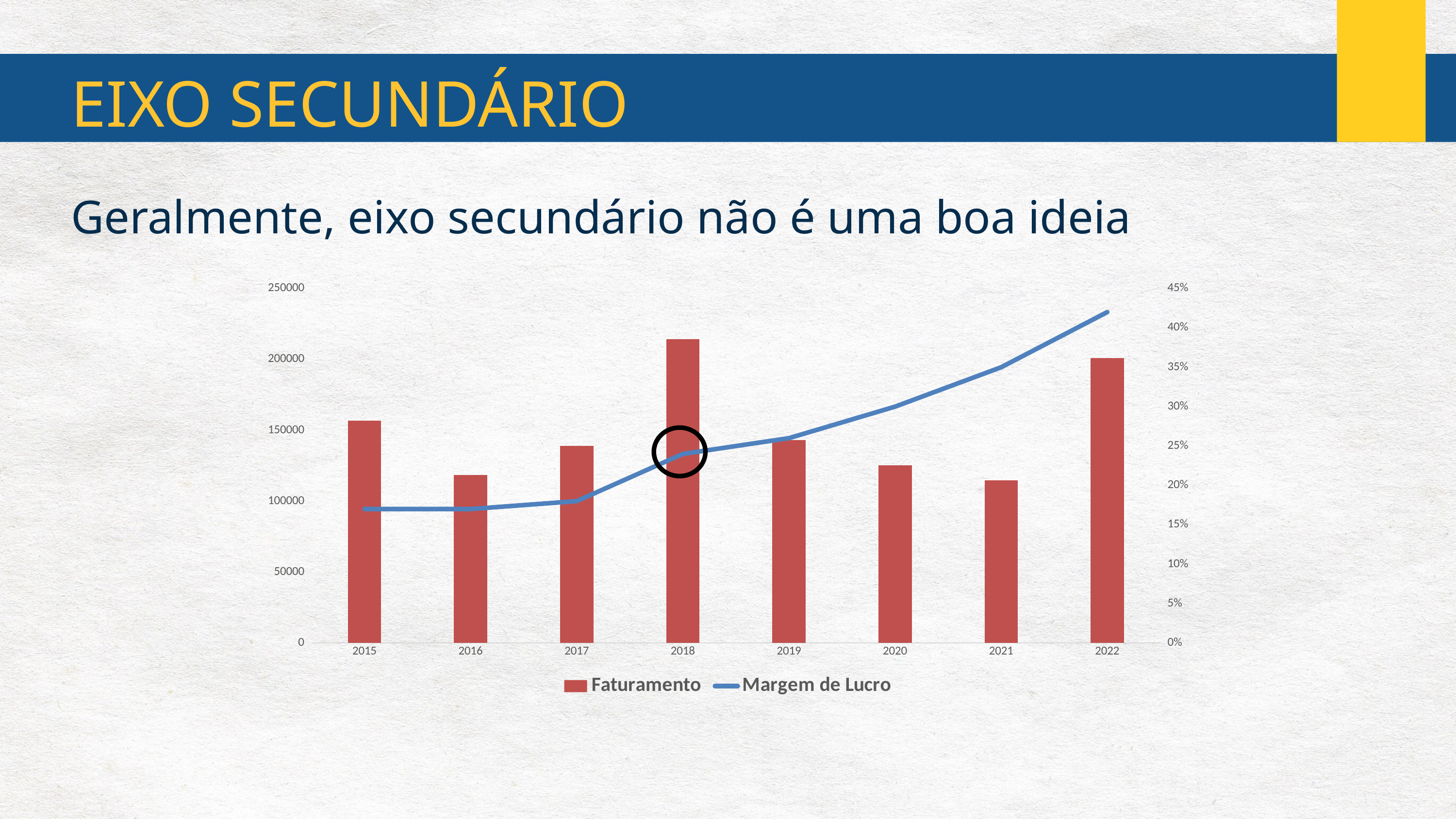
Is the Faturamento value for 2018 greater or less than 200000? greater Which is larger, the Faturamento bar for 2018 or for 2019? 2018 Is the Margem de Lucro value for 2022 greater or less than 40%? greater Which series is drawn as a line in the chart? Margem de Lucro Which year has the highest Faturamento bar? 2018 What kind of chart is shown on the slide? Combined bar and line chart Does the Margem de Lucro line rise or fall from 2015 to 2022? rises Is the Faturamento value for 2021 greater or less than 150000? less How many years are shown on the x axis of the chart? 8 How many series does the chart legend list? 2